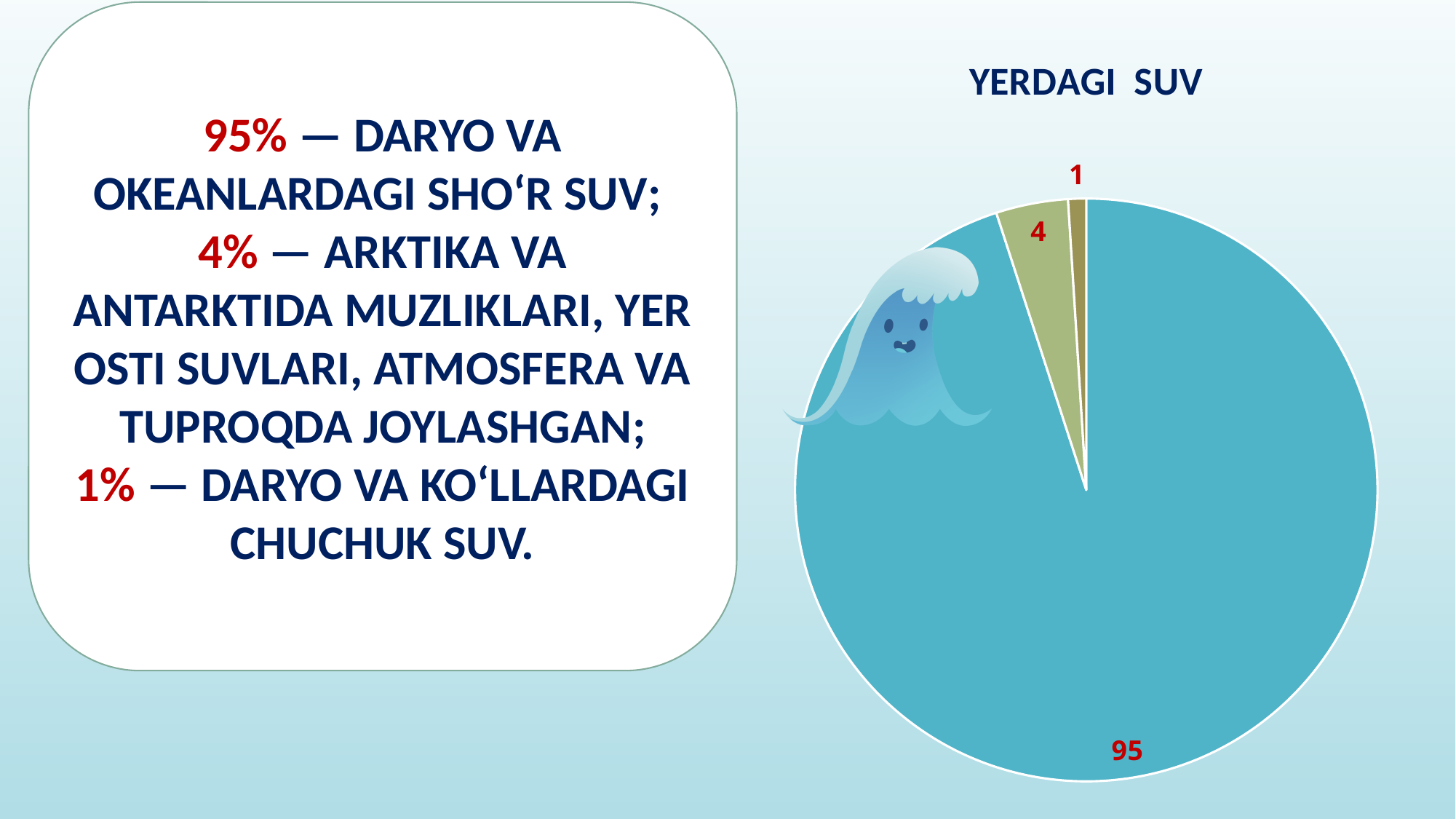
What is the value of the largest slice in the pie chart? 95 Which slice is larger, the one labelled 4 or the one labelled 1? 4 According to the slide text, what percentage of Earth's water is salt water in seas and oceans (DARYO VA OKEANLARDAGI SHO'R SUV)? 95% What is the difference between the slices labelled 4 and 1? 3 What is the title of the pie chart? YERDAGI SUV What is the value of the smallest slice in the pie chart? 1 What is the value of the olive-green slice in the pie chart? 4 What is the difference between the largest slice (95) and the slice labelled 4? 91 According to the slide text, what percentage of Earth's water is fresh water in rivers and lakes (DARYO VA KO'LLARDAGI CHUCHUK SUV)? 1% What is the total of all slice values in the pie chart? 100 What kind of chart is shown on the slide? pie chart How many slices does the pie chart have? 3